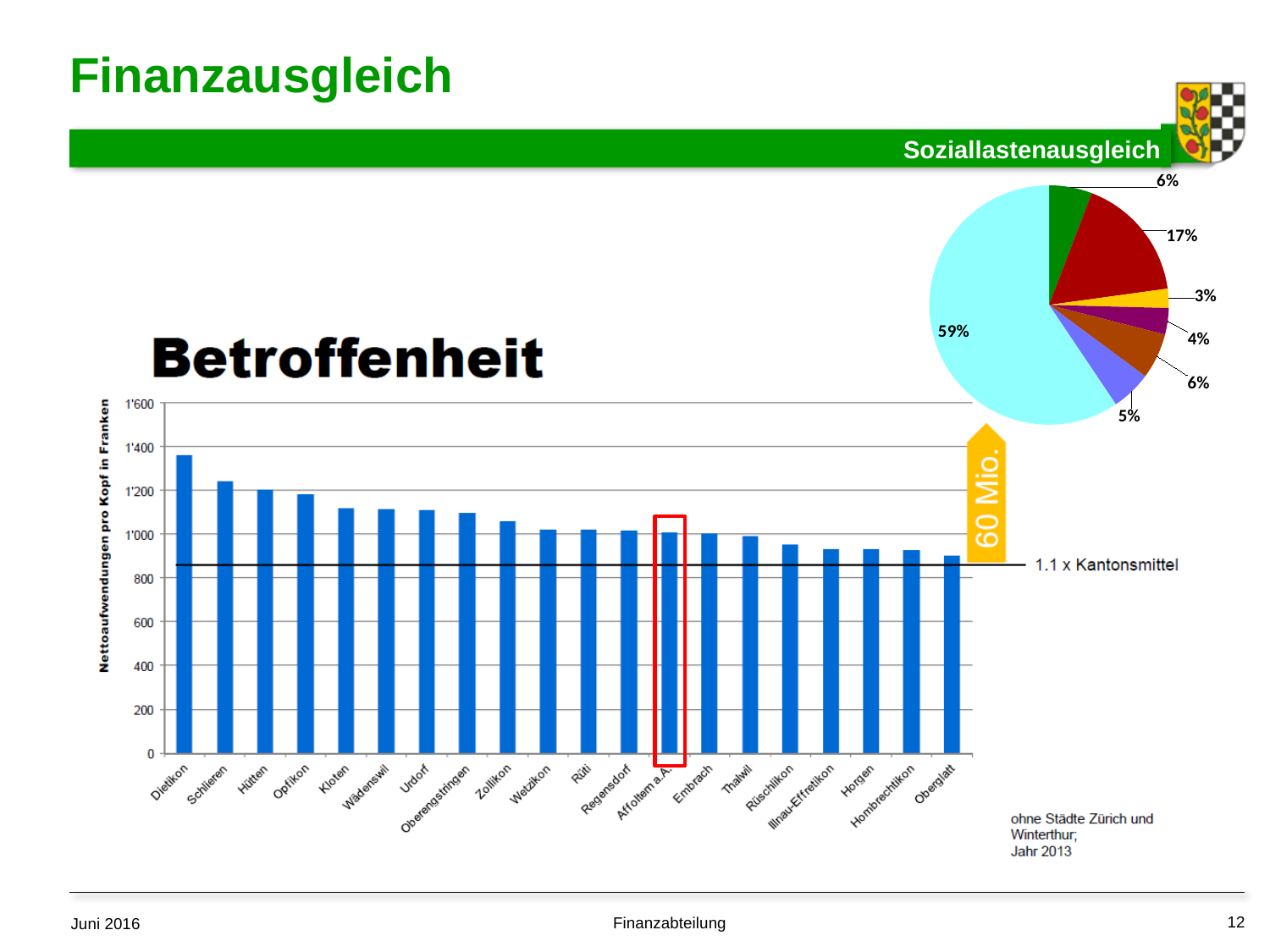
What kind of chart is the 'Betroffenheit' chart on the left of the slide? bar chart What is the label of the horizontal line drawn across the 'Betroffenheit' bar chart? 1.1 x Kantonsmittel In the 'Betroffenheit' bar chart, is the value for Kloten greater or less than 1'000? greater In the pie chart at the top right of the slide, what is the share of the largest slice? 59% In the 'Betroffenheit' bar chart, is the value for Dietikon greater or less than 1'200? greater In the 'Betroffenheit' bar chart, is the value for Oberglatt greater or less than 1'000? less In the 'Betroffenheit' bar chart, which is larger, the value for Schlieren or the value for Horgen? Schlieren How many slices does the pie chart at the top right of the slide have? 7 In the 'Betroffenheit' bar chart, do the values rise or fall from left to right along the x axis? fall In the 'Betroffenheit' bar chart, which municipality has the lowest value? Oberglatt How many municipalities are shown in the 'Betroffenheit' bar chart? 20 In the 'Betroffenheit' bar chart, which municipality has the highest value? Dietikon